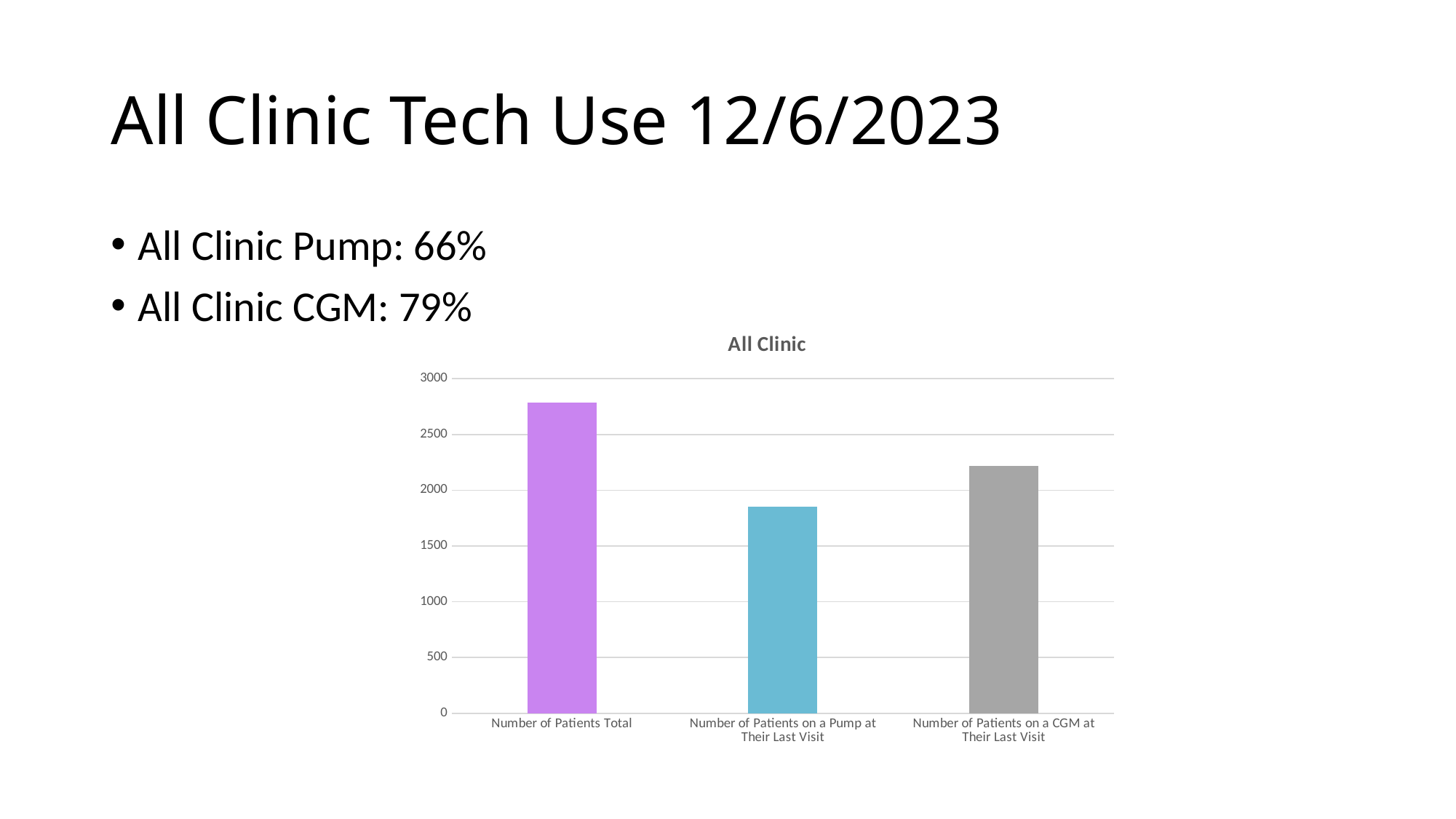
Is the value for Number of Patients on a Pump at Their Last Visit greater or less than 2000? less What is the title of the chart? All Clinic How many categories are plotted in the chart? 3 What colour is the bar for Number of Patients Total? Purple Which category has the lowest bar in the chart? Number of Patients on a Pump at Their Last Visit Is the value for Number of Patients on a CGM at Their Last Visit greater or less than 2500? less Is the value for Number of Patients on a Pump at Their Last Visit greater or less than 1500? greater Which category has the highest bar in the chart? Number of Patients Total What kind of chart is shown on the slide? Bar chart Which is larger: the value for Number of Patients on a CGM at Their Last Visit or the value for Number of Patients on a Pump at Their Last Visit? Number of Patients on a CGM at Their Last Visit